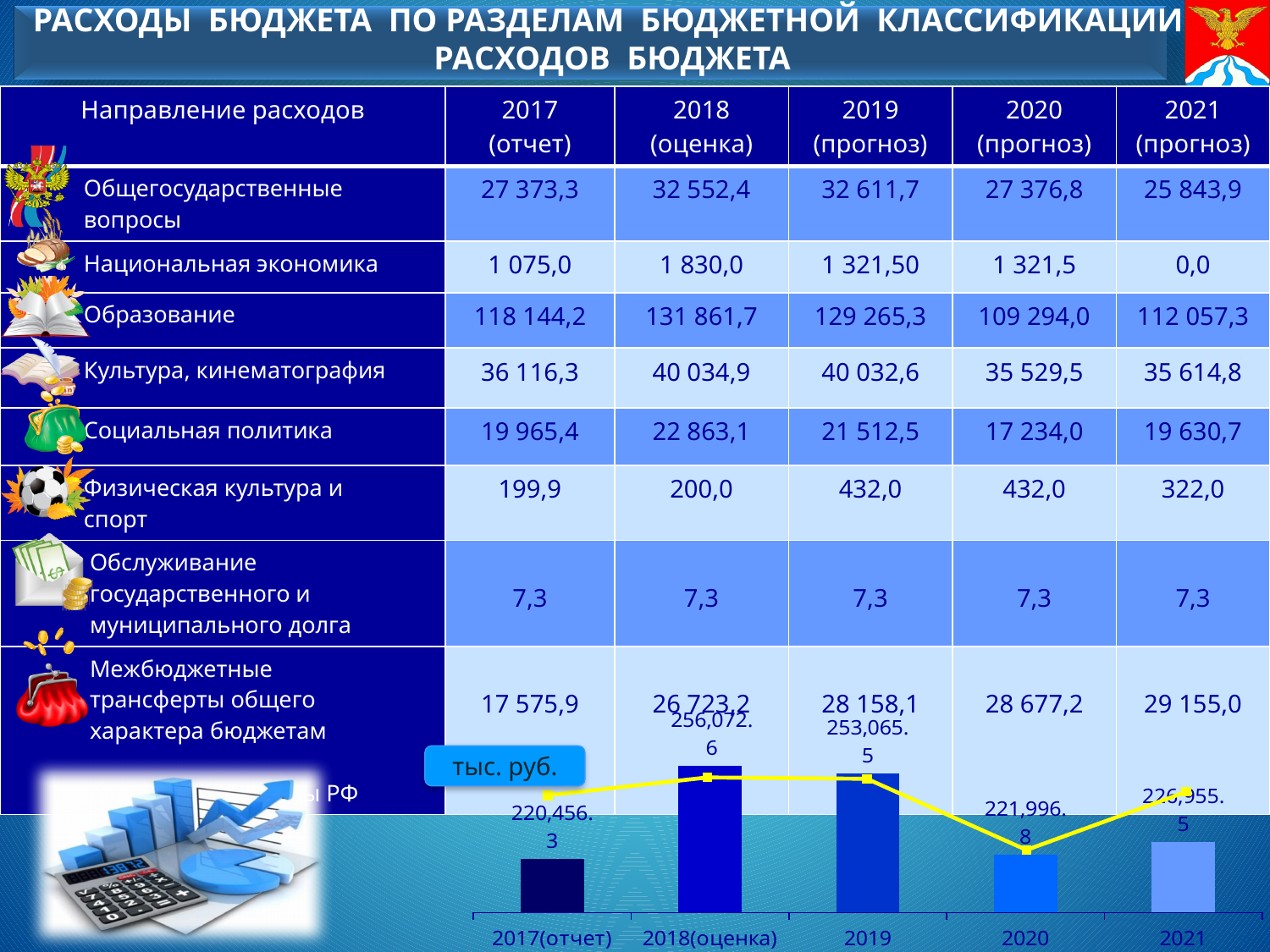
In the chart at the bottom of the slide, what is the difference between the values for 2018(оценка) and 2019? 3,007.1 In the chart at the bottom of the slide, what is the value for 2017(отчет)? 220,456.3 In the chart at the bottom of the slide, what is the value for 2020? 221,996.8 In the chart at the bottom of the slide, which year has the highest value? 2018(оценка) What kind of chart is shown at the bottom of the slide? Bar chart with a line overlay In the chart at the bottom of the slide, what is the difference between the values for 2021 and 2020? 4,958.7 In the chart at the bottom of the slide, what is the value for 2018(оценка)? 256,072.6 In the chart at the bottom of the slide, what is the value for 2021? 226,955.5 How many years are plotted in the chart at the bottom of the slide? 5 In the chart at the bottom of the slide, which is larger: the value for 2019 or the value for 2020? 2019 In the chart at the bottom of the slide, which year has the lowest value? 2017(отчет) In the chart at the bottom of the slide, does the value rise or fall from 2018(оценка) to 2020? Fall